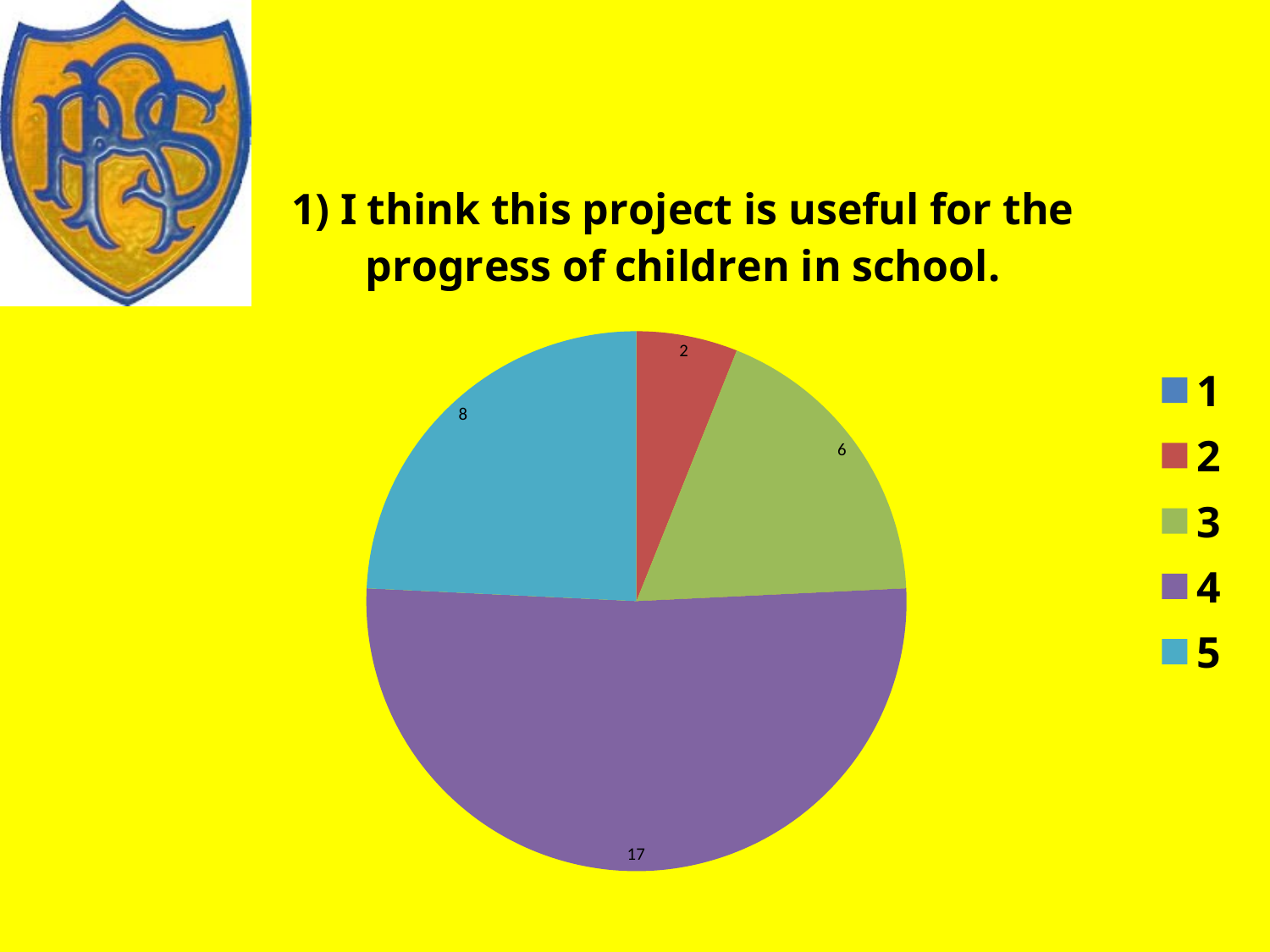
What is the difference between the values for category 4 and category 5? 9 What is the value of the slice for category 3? 6 What is the value of the slice for category 4? 17 Which is larger, the slice for category 5 or the slice for category 3? 5 What is the difference between the values for category 3 and category 2? 4 What is the value of the slice for category 2? 2 Which labelled slice has the smallest value? 2 What colour is the slice for category 4? purple What is the value of the slice for category 5? 8 What type of chart is shown on the slide? pie chart Which category has the largest slice of the pie? 4 How many entries does the legend list? 5